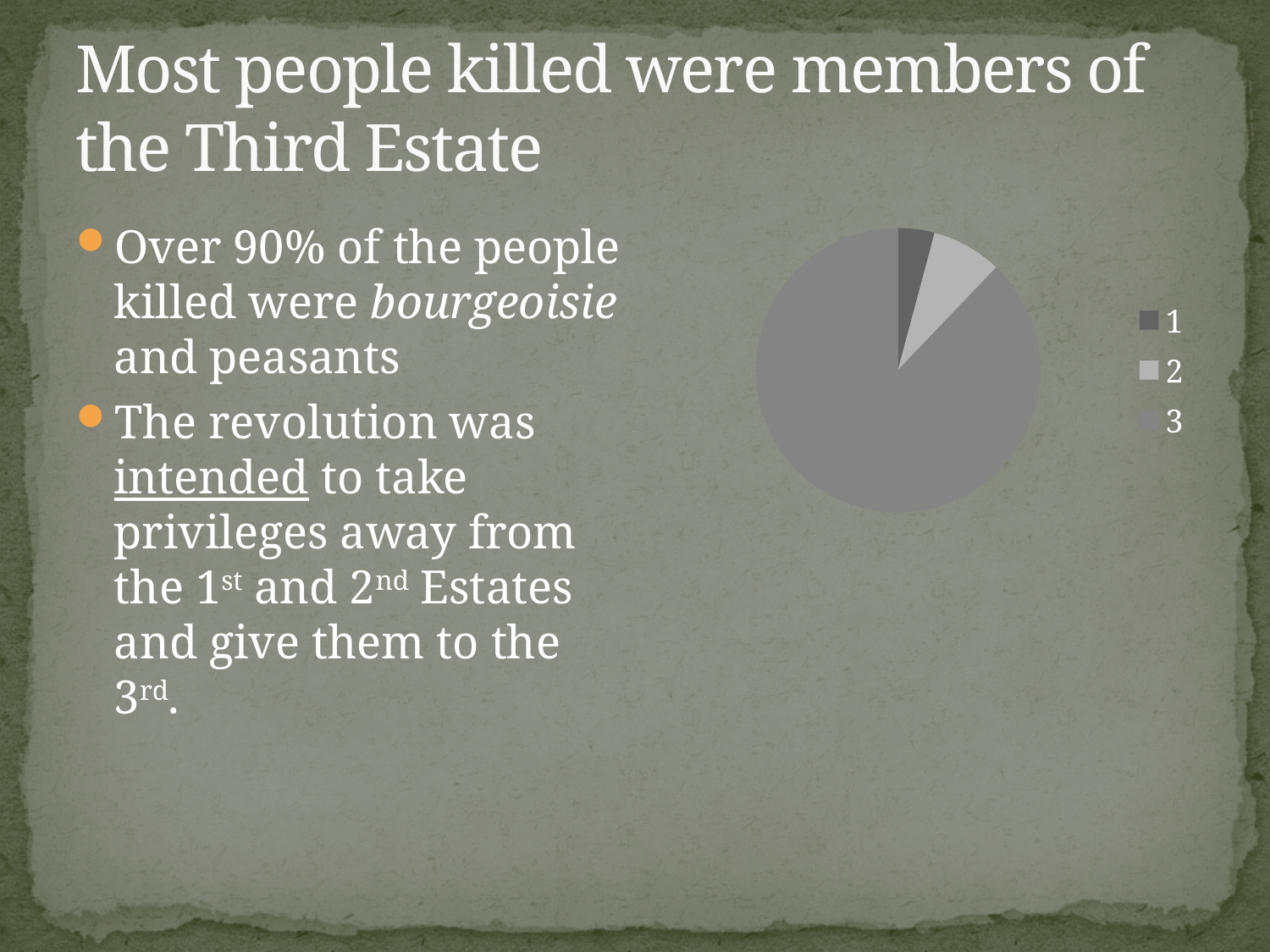
Which category has the largest slice in the pie chart? 3 Which slice is larger in the pie chart, 1 or 2? 2 What kind of chart is shown on the slide? pie chart Which slice is larger in the pie chart, 2 or 3? 3 Does slice 3 take up more or less than half of the pie chart? more Which category has the smallest slice in the pie chart? 1 How many slices does the pie chart have? 3 What are the labels listed in the legend of the pie chart? 1, 2, 3 How many entries does the legend of the pie chart list? 3 Which legend entry is shown in the lightest shade of gray in the pie chart? 2